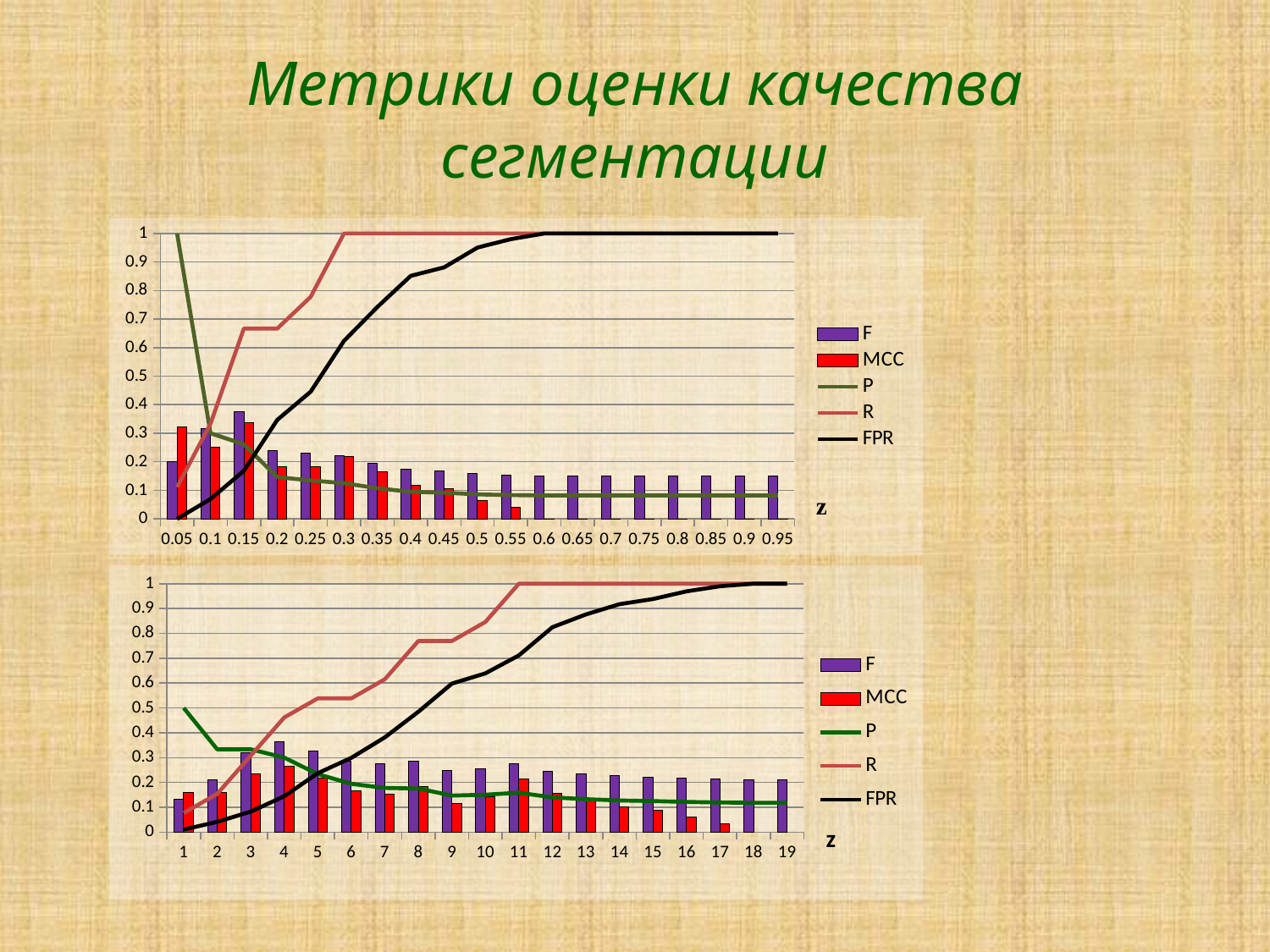
How many series does the legend of the top chart list? 5 In the bottom chart, what colour is the FPR line? black How many z categories are shown on the x axis of the bottom chart? 19 What kind of chart is the top chart? Combined bar and line chart In the bottom chart, what is the value of P at z = 1? 0.5 Which series are listed in the legend of the bottom chart? F, MCC, P, R, FPR In the top chart, what is the value of R at z = 0.6? 1 In the top chart, does the FPR line rise or fall as z increases? rises In the top chart, which is larger at z = 0.05, F or MCC? MCC In the top chart, at which z value is the F bar highest? 0.15 In the top chart, is the value of MCC at z = 0.05 greater or less than 0.3? greater In the bottom chart, which is larger at z = 17, F or MCC? F